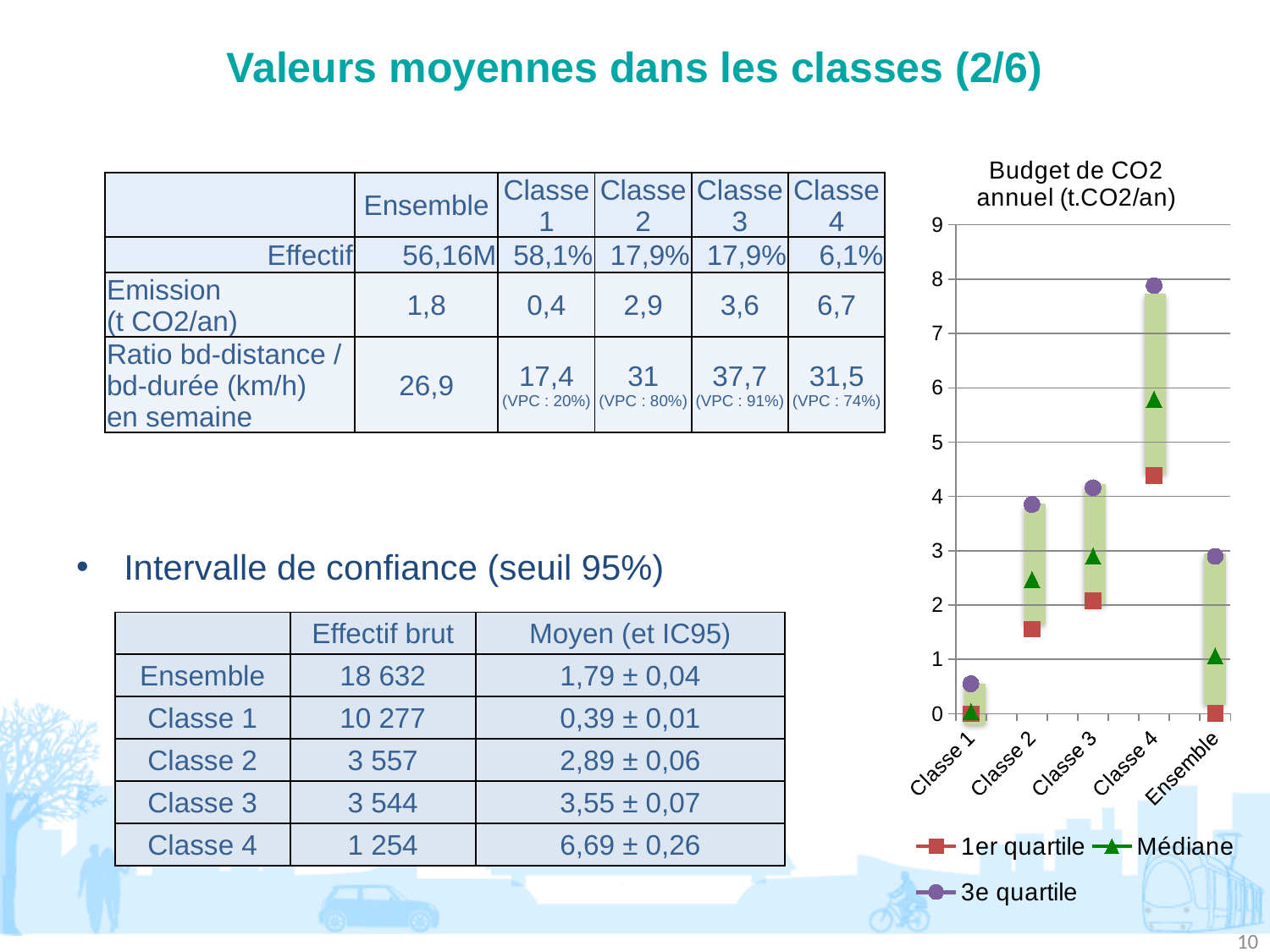
How many categories are shown on the x axis of the chart? 5 How many series does the chart legend list? 3 Which category has the highest 3e quartile value in the chart? Classe 4 Is the 3e quartile value for Ensemble greater or less than 2? greater What is the title of the chart on the right of the slide? Budget de CO2 annuel (t.CO2/an) Is the 3e quartile value for Classe 4 greater or less than 7? greater Is the Médiane value for Classe 2 greater or less than 3? less Do the Médiane values rise or fall from Classe 1 to Classe 4? rise Which category has the lowest Médiane value in the chart? Classe 1 Which has the larger Médiane value, Classe 2 or Classe 3? Classe 3 Which series are listed in the chart legend? 1er quartile, Médiane, 3e quartile